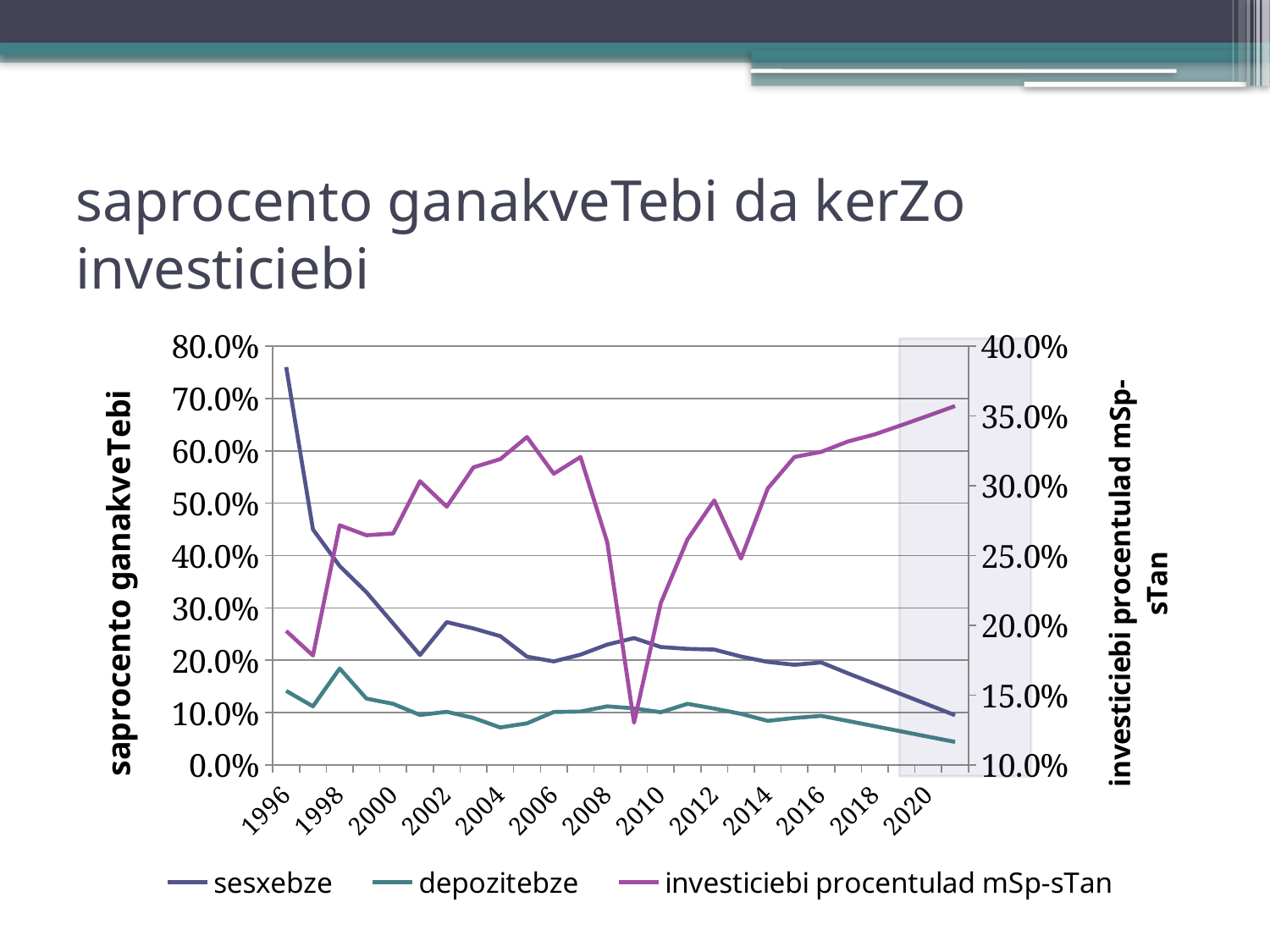
What is the title of the slide? saprocento ganakveTebi da kerZo investiciebi Is the value for depozitebze in 1996 greater or less than 20.0%? less What kind of chart is shown on the slide? line chart What is the label of the left vertical axis? saprocento ganakveTebi Is the value for sesxebze in 1996 greater or less than 70.0%? greater In which year is the sesxebze series at its highest? 1996 Which is larger in 2000, sesxebze or depozitebze? sesxebze Does the sesxebze series generally rise or fall from 1996 to 2021? fall In which year is the investiciebi procentulad mSp-sTan series at its lowest? 2009 In which year is the depozitebze series at its highest? 1998 How many series does the legend list? 3 Is the value for investiciebi procentulad mSp-sTan in 2009 greater or less than 15.0% on the right axis? less